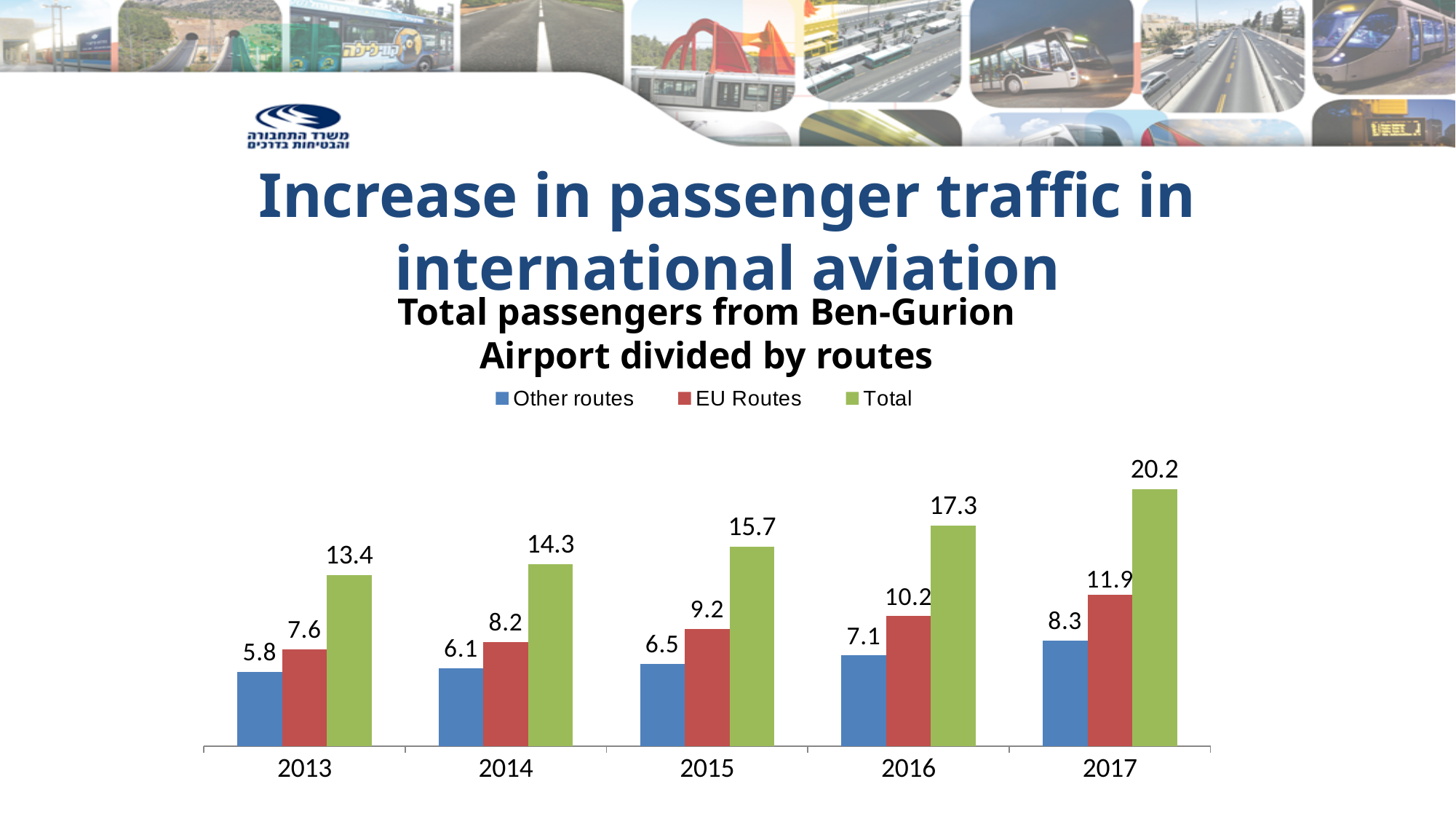
Which year has the lowest value for EU Routes? 2013 What is the value for EU Routes in 2015? 9.2 Do the Total values rise or fall from 2013 to 2017? Rise Which is larger in 2014: EU Routes or Other routes? EU Routes What is the difference between EU Routes and Other routes in 2016? 3.1 What kind of chart is shown on the slide? Bar chart How many series does the legend list? 3 What is the value for Total in 2017? 20.2 What is the difference between the Total values for 2017 and 2013? 6.8 How many years are shown on the x axis? 5 What is the value for Other routes in 2013? 5.8 Which year has the highest Total value? 2017